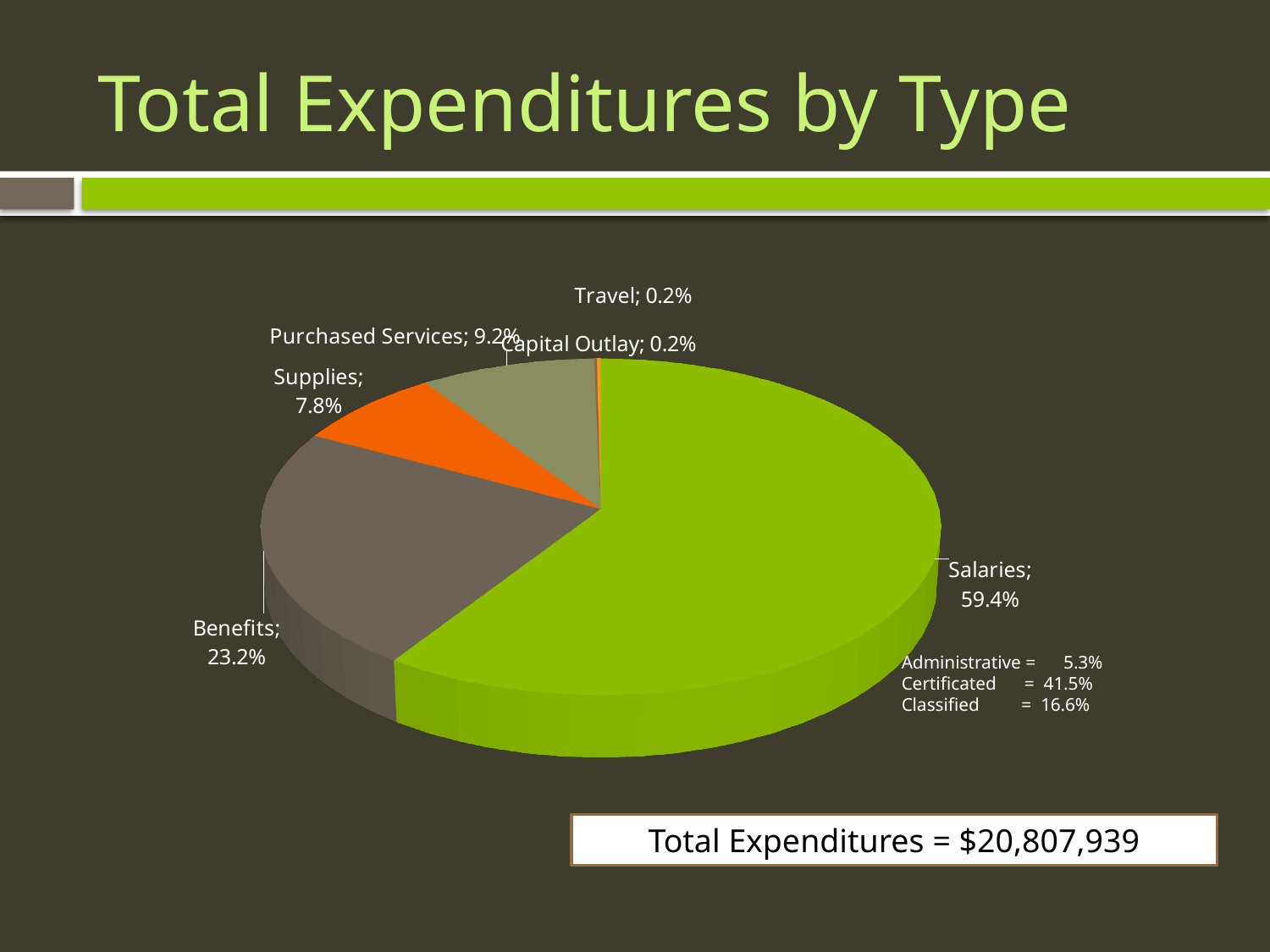
How many slices does the pie chart have? 6 What share of the pie is Purchased Services? 9.2% What is the difference in percentage points between Purchased Services and Supplies? 1.4 Which expenditure type has the largest share of the pie? Salaries What percentage is shown for Capital Outlay? 0.2% What percentage is shown for Supplies? 7.8% What kind of chart is shown on the slide? Pie chart What is the title of the slide containing the pie chart? Total Expenditures by Type What percentage of total expenditures is Salaries? 59.4% Which is larger, the share for Benefits or the share for Purchased Services? Benefits What is the difference in percentage points between Salaries and Benefits? 36.2 What percentage of total expenditures is Benefits? 23.2%